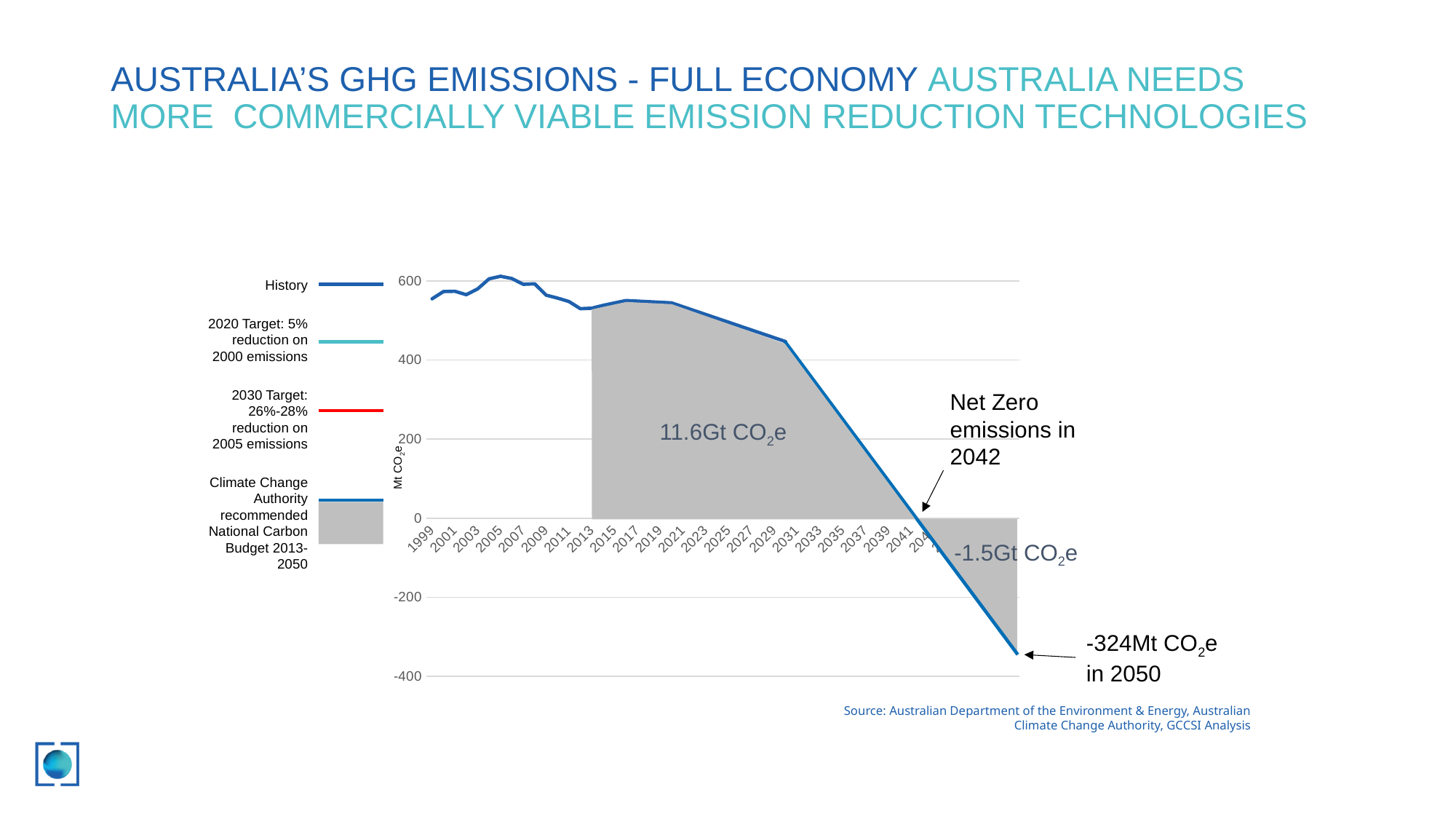
What is the label on the vertical axis of the chart? Mt CO2e What cumulative value is printed in the shaded area above zero? 11.6Gt CO2e What emissions value does the chart annotate for 2050? -324Mt CO2e What kind of chart is shown on the slide? line chart How many entries does the chart legend list? 4 Which is larger, the value for 2005 or the value for 2031? 2005 From 2013 onward, do the plotted emissions values rise or fall along the x axis? fall Is the value for 1999 greater or less than 400? greater Is the value for 2045 greater or less than 0? less What cumulative value is printed in the shaded area below zero? -1.5Gt CO2e In which year does the plotted line reach its lowest value? 2050 In which year does the chart indicate net zero emissions are reached? 2042